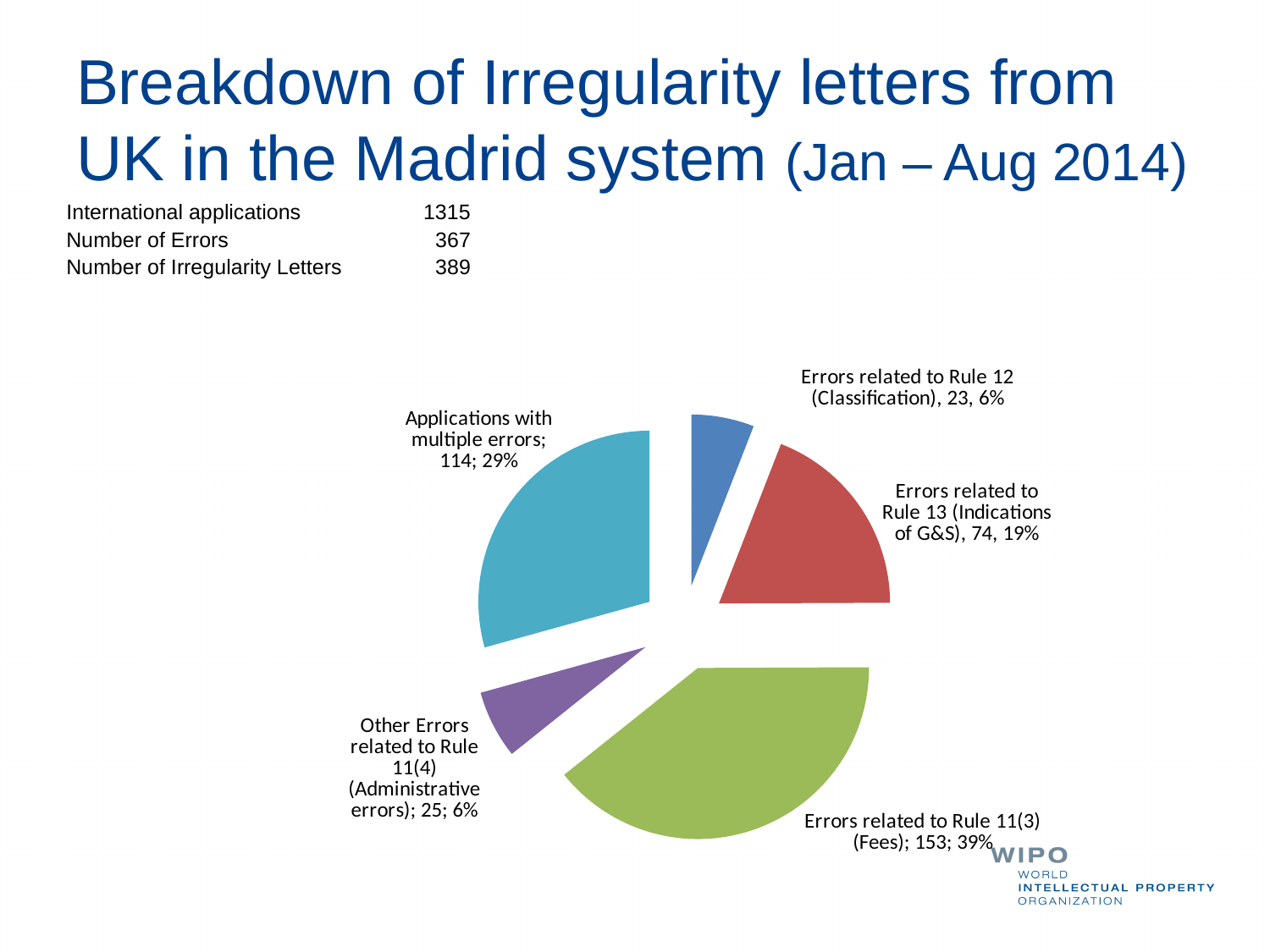
What share of the pie is Applications with multiple errors? 29% What is the value for Errors related to Rule 12 (Classification)? 23 What is the difference between the values for Errors related to Rule 11(3) (Fees) and Errors related to Rule 13 (Indications of G&S)? 79 How many slices does the pie chart have? 5 What share of the pie is Other Errors related to Rule 11(4) (Administrative errors)? 6% Which slice is the largest? Errors related to Rule 11(3) (Fees) What is the value for Errors related to Rule 11(3) (Fees)? 153 Which slice is the smallest? Errors related to Rule 12 (Classification) What kind of chart is shown on the slide? pie chart What is the value for Applications with multiple errors? 114 What is the value for Errors related to Rule 13 (Indications of G&S)? 74 Which is larger, the value for Applications with multiple errors or the value for Errors related to Rule 13 (Indications of G&S)? Applications with multiple errors